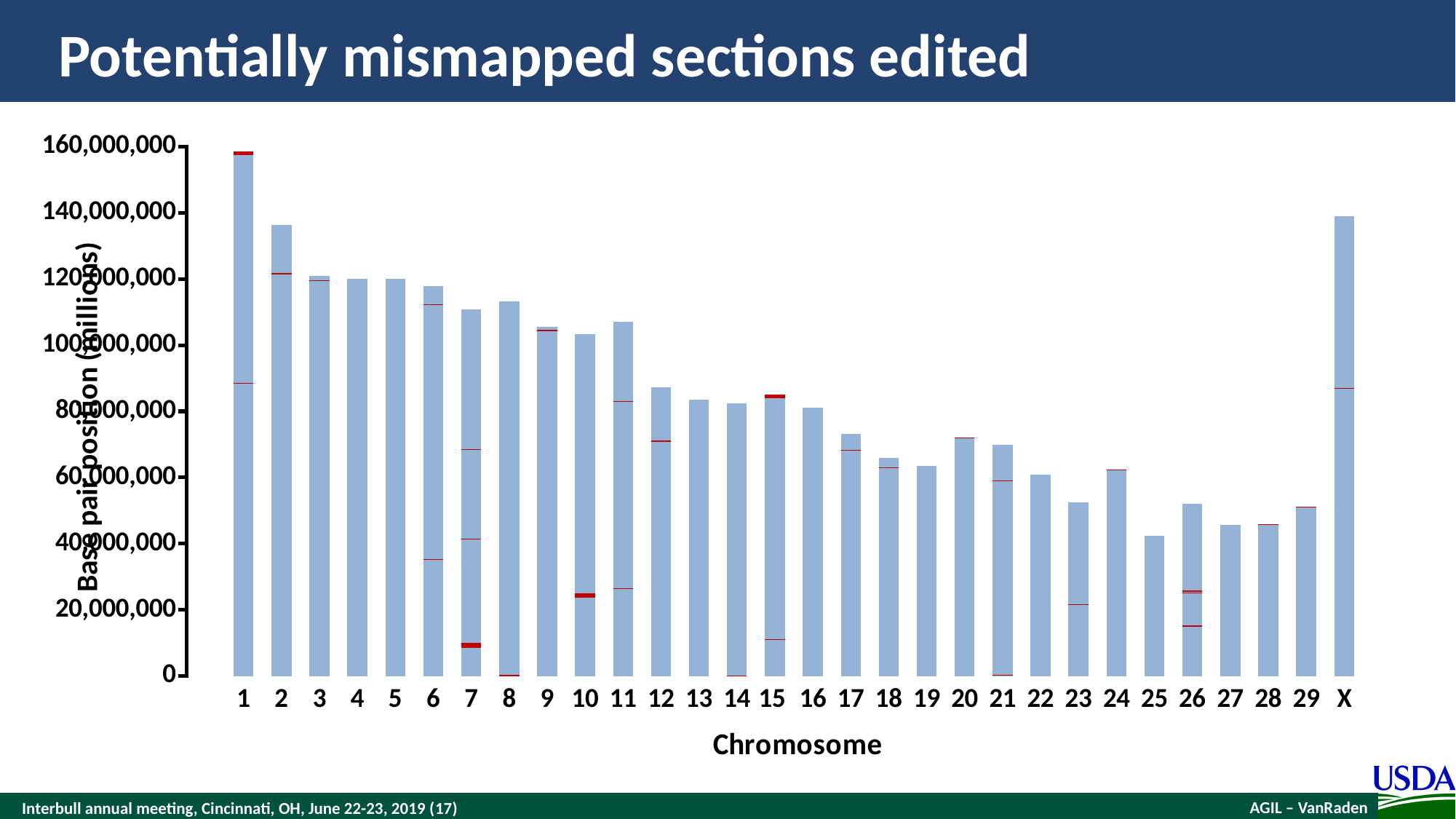
How many chromosomes are plotted along the x axis? 30 Is the value for chromosome 12 greater or less than 100,000,000? less Is the value for chromosome 7 greater or less than 120,000,000? less Is the value for chromosome 25 greater or less than 40,000,000? greater What kind of chart is shown on the slide? bar chart Which chromosome has the highest base pair position? 1 Which has a larger base pair position, chromosome 1 or chromosome X? chromosome 1 Which chromosome has the lowest base pair position? 25 Do the bar heights generally rise or fall from chromosome 1 to chromosome 29? fall Which has a larger base pair position, chromosome 20 or chromosome 19? chromosome 20 What is the label on the x axis of the chart? Chromosome